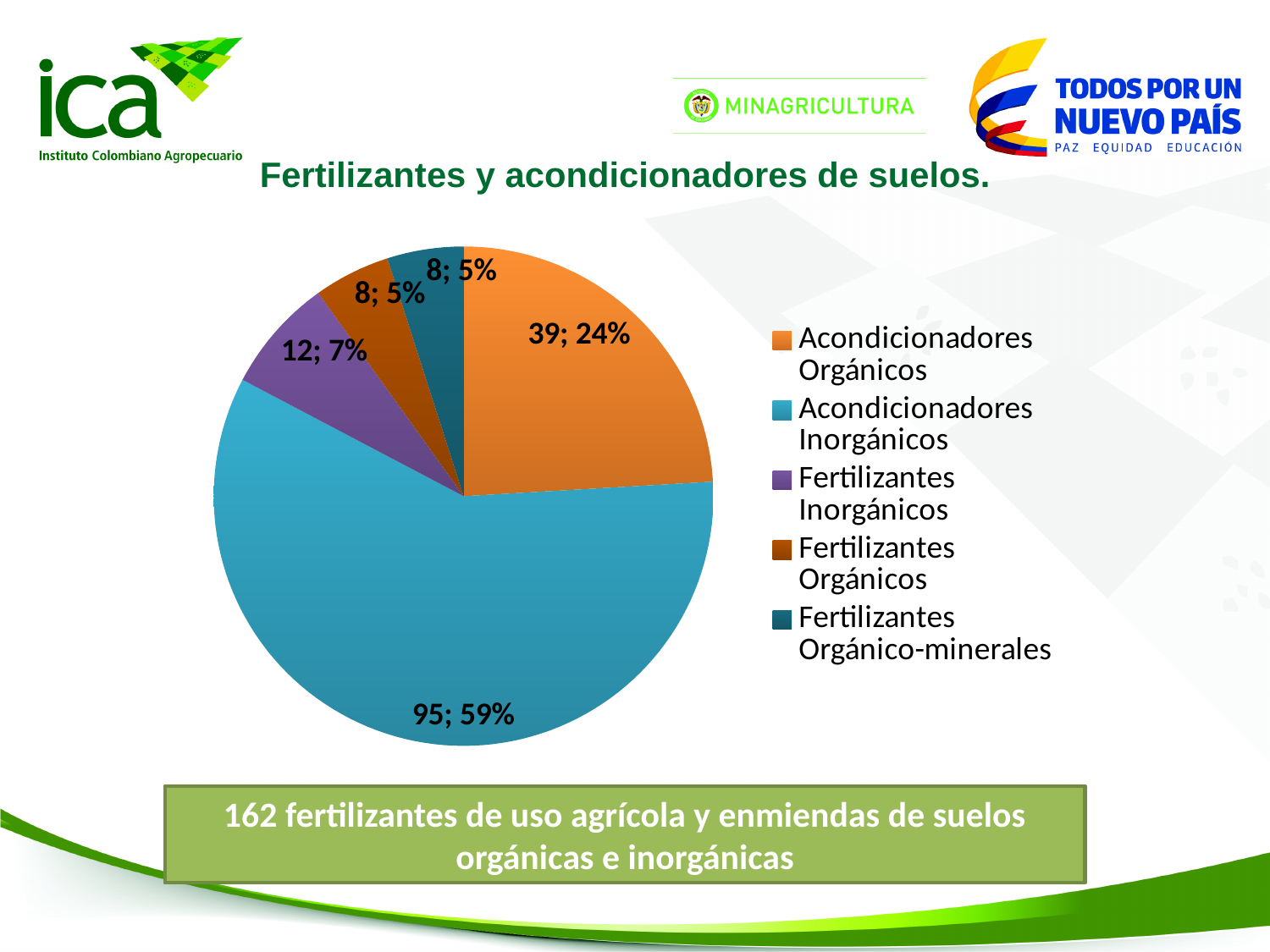
What percentage share does the Acondicionadores Inorgánicos slice have? 59% What is the difference between the values for Acondicionadores Inorgánicos and Acondicionadores Orgánicos? 56 Which category has the largest slice of the pie? Acondicionadores Inorgánicos How many categories does the pie chart show? 5 What is the title of the chart on the slide? Fertilizantes y acondicionadores de suelos. Which is larger, the value for Acondicionadores Orgánicos or the value for Fertilizantes Inorgánicos? Acondicionadores Orgánicos What kind of chart is shown on the slide? pie chart What is the total of all the values in the pie chart? 162 What percentage share does the Acondicionadores Orgánicos slice have? 24% What colour is the slice for Fertilizantes Inorgánicos? purple What is the value shown for Acondicionadores Inorgánicos? 95 What is the value shown for Fertilizantes Inorgánicos? 12